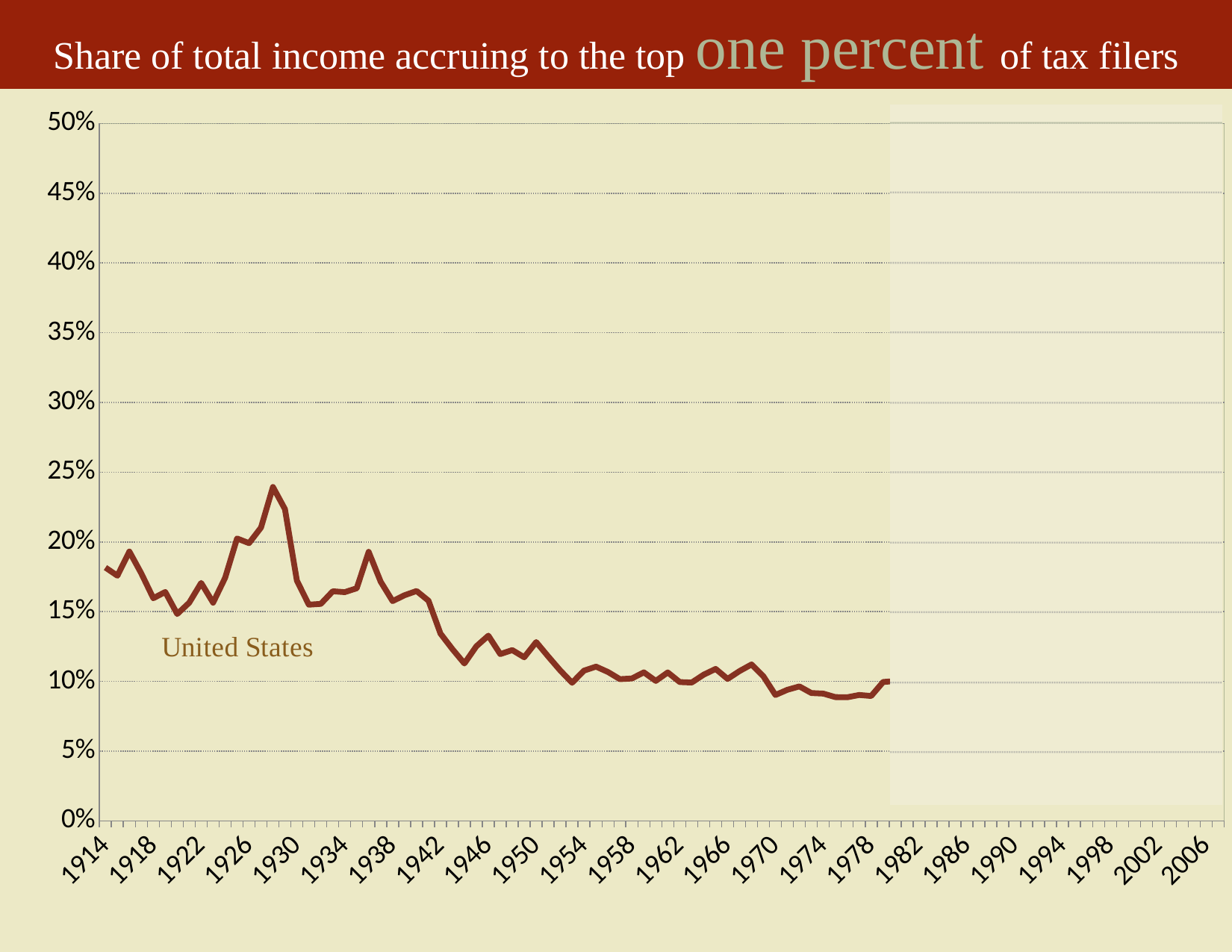
In which year does the line reach its highest value? 1928 What is the title of the chart? Share of total income accruing to the top one percent of tax filers How many data series are plotted on the chart? 1 Which country does the plotted line represent? United States Which year has the larger value, 1928 or 1950? 1928 Is the value for 1946 greater or less than 15%? less Is the value for 1914 greater or less than 15%? greater Overall, does the line rise or fall from 1914 to 1980? fall What kind of chart is shown on the slide? line chart Is the value for 1936 greater or less than 15%? greater